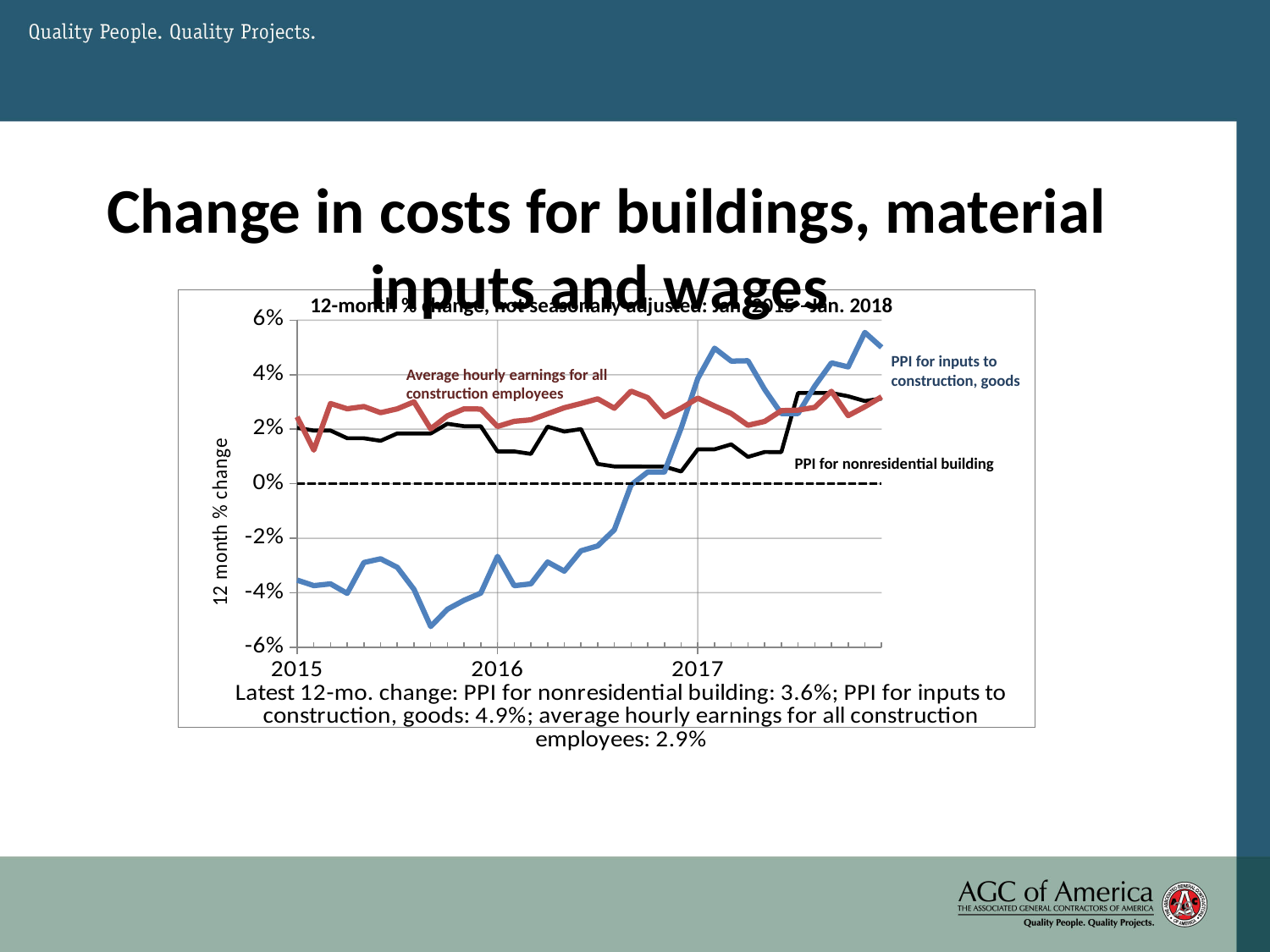
Does the PPI for inputs to construction, goods line generally rise or fall from 2015 to the end of the period? rise According to the note below the chart, what is the latest 12-month change in the PPI for nonresidential building? 3.6% Which series has the lowest latest 12-month change? Average hourly earnings for all construction employees At the start of 2015, is the value for PPI for inputs to construction, goods greater or less than -2%? less How many data series are plotted on the chart? 3 According to the note below the chart, what is the latest 12-month change in average hourly earnings for all construction employees? 2.9% What kind of chart is shown on the slide? line chart According to the note below the chart, what is the latest 12-month change in the PPI for inputs to construction, goods? 4.9% Which series has the highest latest 12-month change? PPI for inputs to construction, goods Is the latest value for PPI for inputs to construction, goods larger or smaller than the latest value for average hourly earnings? larger What label is shown on the vertical axis of the chart? 12 month % change What is the difference between the latest 12-month change for PPI for inputs to construction, goods and for PPI for nonresidential building? 1.3%